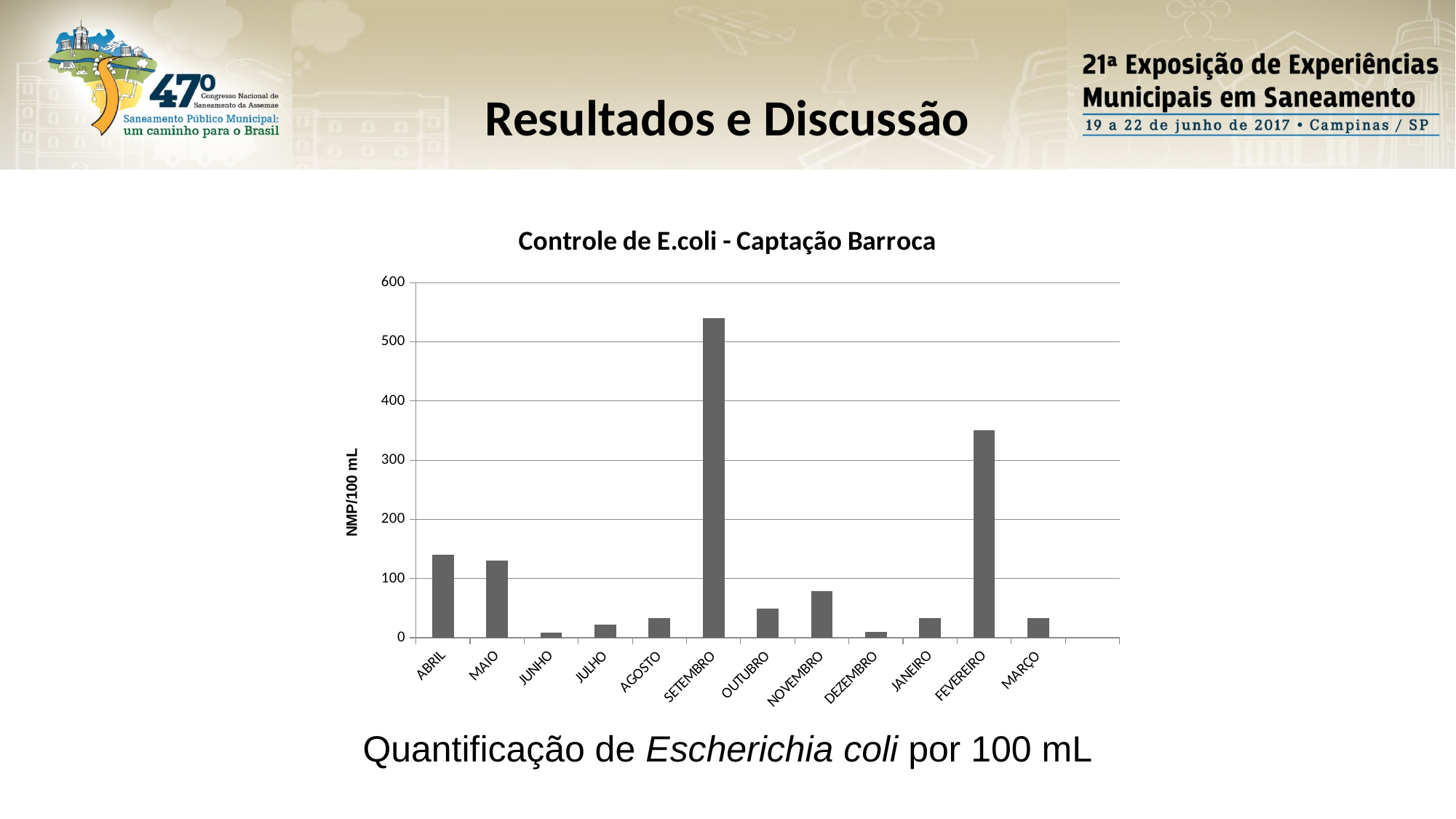
Is the value for NOVEMBRO greater or less than 100? less Is the value for SETEMBRO greater or less than 500? greater Is the value for FEVEREIRO greater or less than 300? greater How many months are shown on the x axis? 12 Which month has the highest E. coli value? SETEMBRO Which is larger, the value for MAIO or the value for OUTUBRO? MAIO What is the title of the chart? Controle de E.coli - Captação Barroca What is the label of the vertical axis? NMP/100 mL Which is larger, the value for SETEMBRO or the value for FEVEREIRO? SETEMBRO What kind of chart is shown on the slide? bar chart